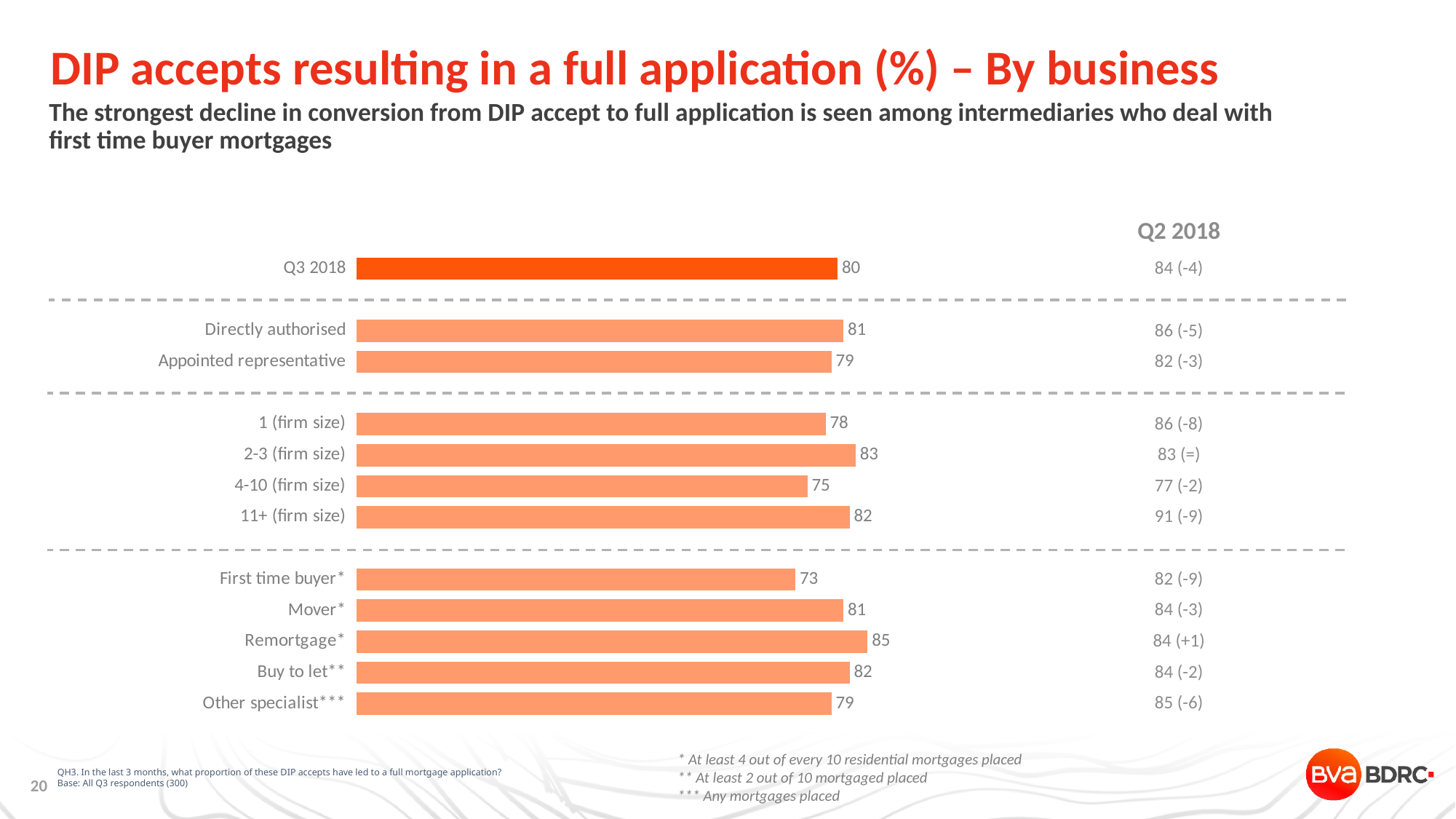
Which category has the lowest value? First time buyer What kind of chart is shown on the slide? Bar chart Which is larger, the value for 2-3 (firm size) or 4-10 (firm size)? 2-3 (firm size) What is the value for Q3 2018 overall? 80 What is the value for 4-10 (firm size)? 75 What is the difference between the values for Directly authorised and Appointed representative? 2 How many bars are plotted in the chart? 12 What is the difference between the values for Remortgage and First time buyer? 12 Which category has the highest value? Remortgage What is the value for Remortgage? 85 What is the value for First time buyer? 73 What is the Q2 2018 value shown for 11+ (firm size)? 91 (-9)